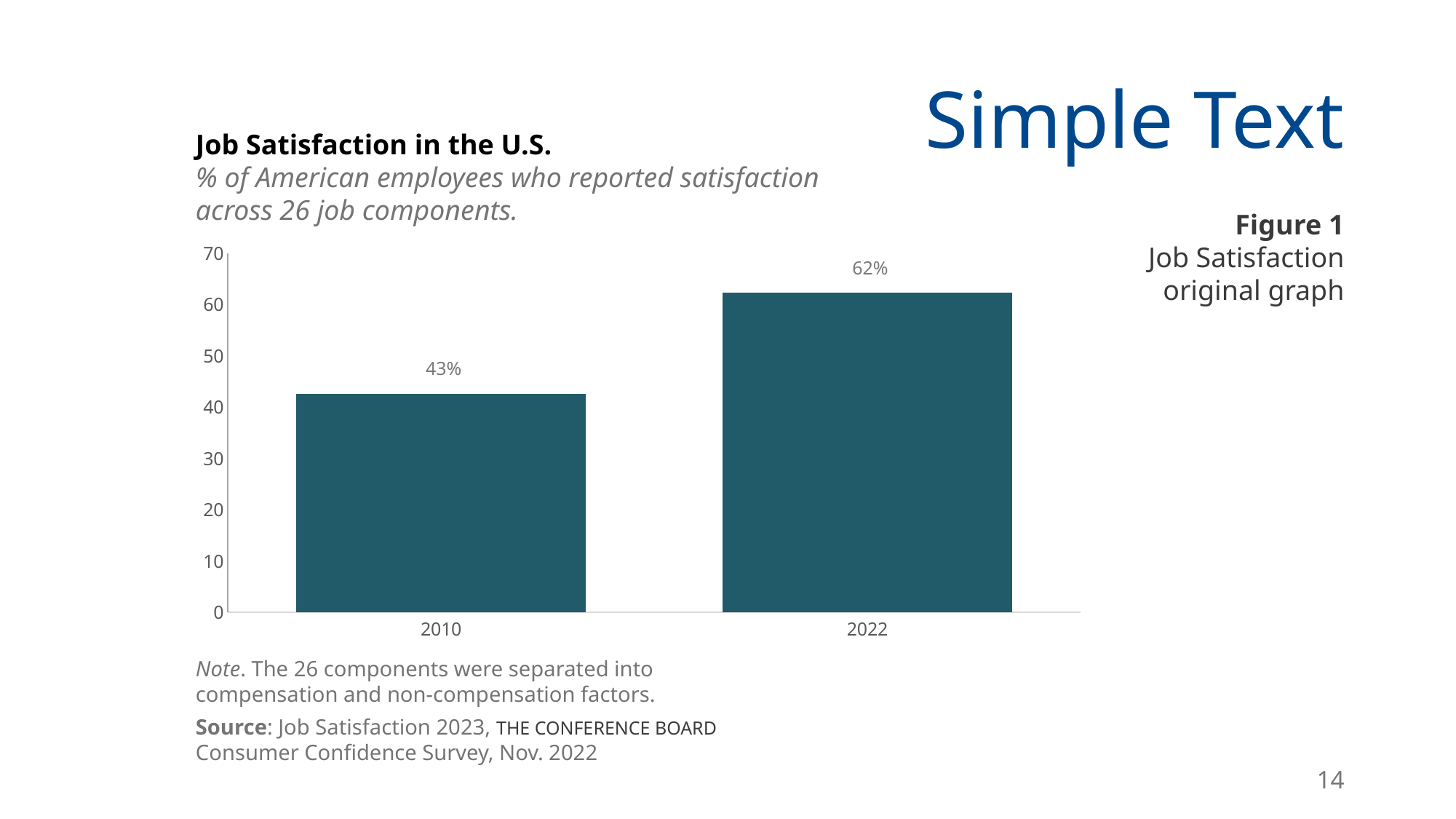
Which year has the highest value? 2022 What is the value for 2022? 62% Do the values rise or fall from 2010 to 2022? rise What is the value for 2010? 43% Is the value for 2010 greater or less than 50? less Which is larger, the value for 2010 or the value for 2022? 2022 What is the difference between the values for 2022 and 2010? 19% Is the value for 2022 greater or less than 60? greater What kind of chart is shown? bar chart Which year has the lowest value? 2010 What is the title of the chart? Job Satisfaction in the U.S. How many categories are shown on the x axis? 2